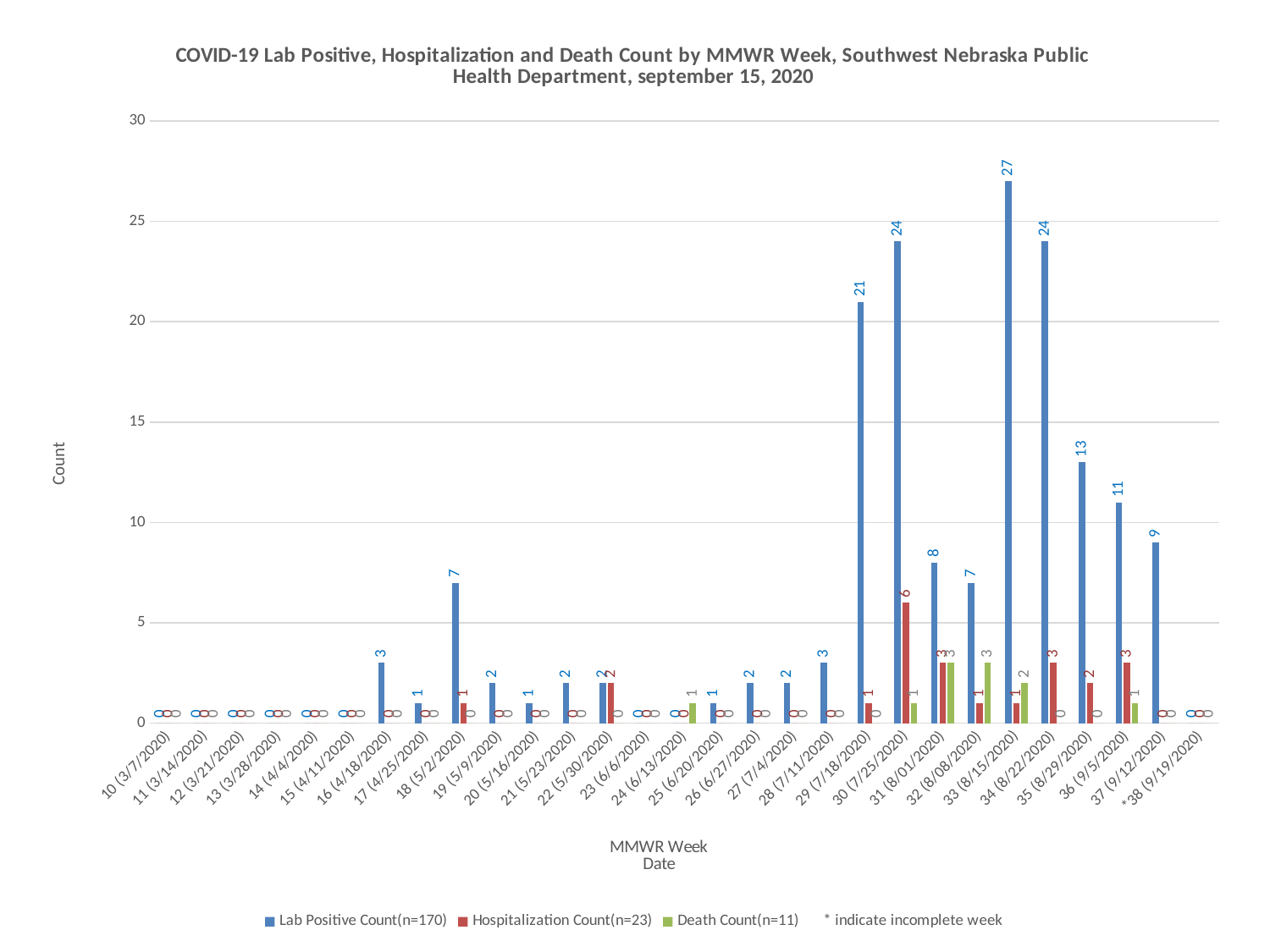
What is the Lab Positive Count for MMWR week 33 (8/15/2020)? 27 Which MMWR week has the highest Hospitalization Count? 30 (7/25/2020) What kind of chart is shown on the slide? Bar chart Which MMWR week has the highest Lab Positive Count? 33 (8/15/2020) What is the difference between the Lab Positive Count for week 30 (7/25/2020) and week 29 (7/18/2020)? 3 What is the Death Count for MMWR week 32 (8/08/2020)? 3 How many series does the legend list? 3 What is the Lab Positive Count for MMWR week 18 (5/2/2020)? 7 Which has the larger Lab Positive Count, week 35 (8/29/2020) or week 36 (9/5/2020)? 35 (8/29/2020) How many MMWR weeks are shown on the x axis? 29 Is the Lab Positive Count for week 34 (8/22/2020) greater or less than 20? greater What is the Hospitalization Count for MMWR week 30 (7/25/2020)? 6